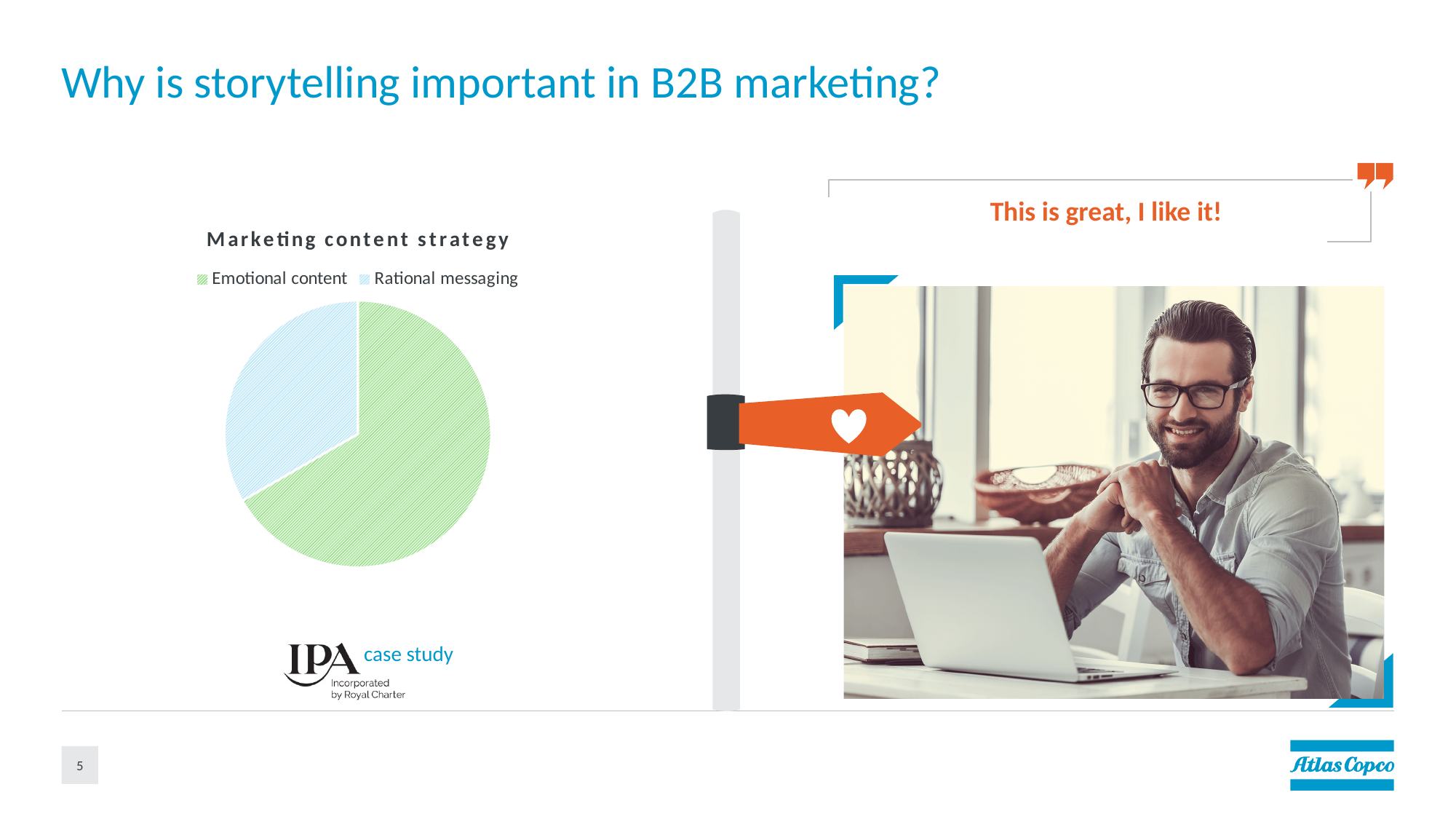
In the "Marketing content strategy" pie chart, which is larger: Emotional content or Rational messaging? Emotional content How many slices does the "Marketing content strategy" pie chart have? 2 Which slice of the "Marketing content strategy" pie chart is the smallest? Rational messaging What kind of chart is shown under the title "Marketing content strategy"? pie chart Which slice of the "Marketing content strategy" pie chart is the largest? Emotional content How many entries does the legend of the "Marketing content strategy" chart list? 2 What is the title of the chart on the left of the slide? Marketing content strategy Does Emotional content take up more or less than half of the "Marketing content strategy" pie chart? more In the "Marketing content strategy" pie chart, which colour represents Rational messaging? light blue